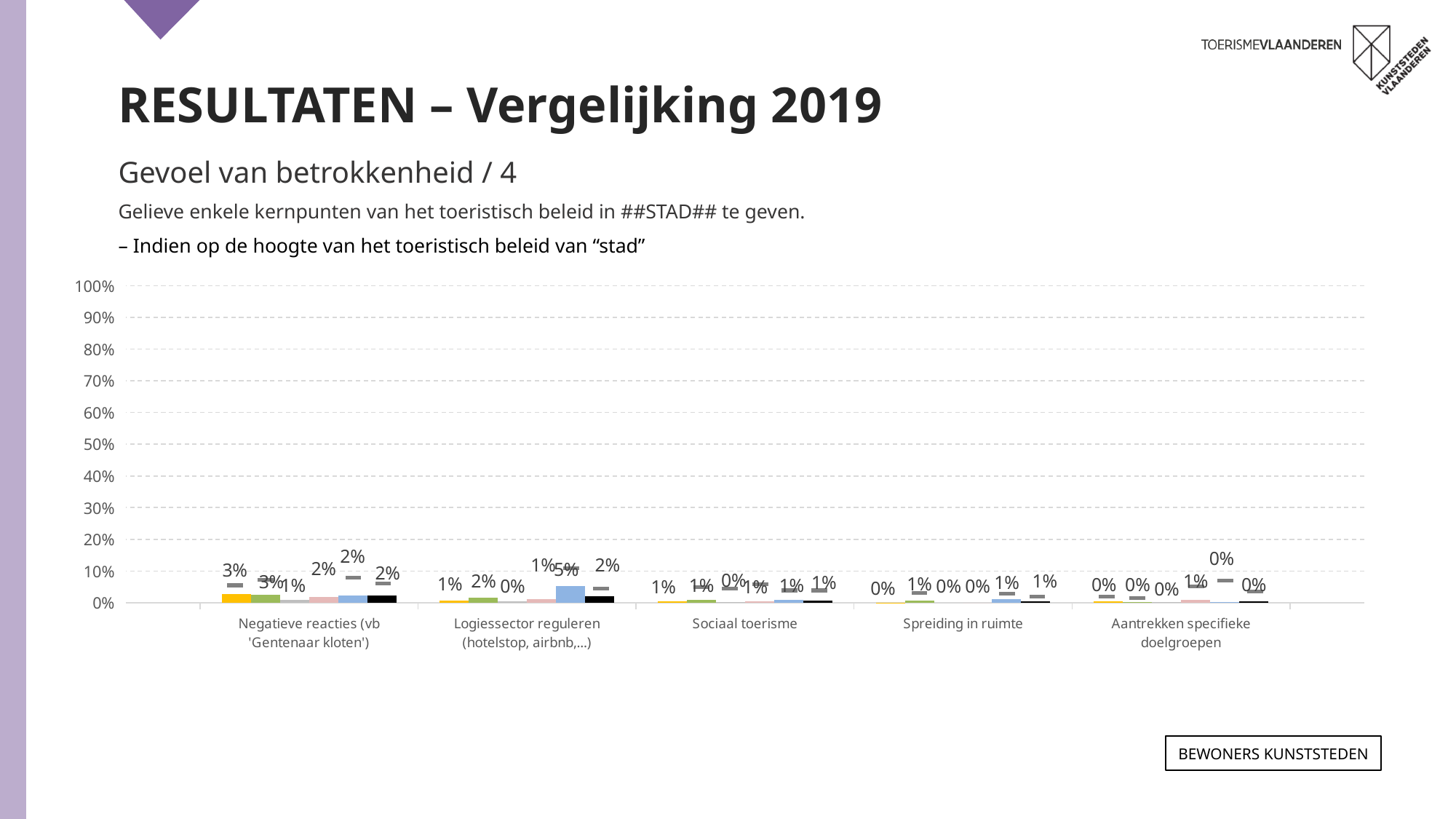
How many bars are plotted for each category in the chart? 6 What is the value of the blue bar for 'Negatieve reacties (vb 'Gentenaar kloten')'? 2% Which category contains the tallest bar in the chart? Logiessector reguleren (hotelstop, airbnb,...) Is the value of the blue bar for 'Logiessector reguleren' greater or less than 10%? less What is the difference between the blue bar for 'Logiessector reguleren' (5%) and the blue bar for 'Negatieve reacties' (2%)? 3% What is the value of the yellow bar for 'Negatieve reacties (vb 'Gentenaar kloten')'? 3% What is the value of the blue bar for 'Logiessector reguleren (hotelstop, airbnb,...)'? 5% What is the label of the last category on the x axis? Aantrekken specifieke doelgroepen How many categories are shown on the x axis of the chart? 5 What kind of chart is shown on the slide? bar chart What is the highest value shown on the y axis of the chart? 100% Which is larger: the blue bar for 'Logiessector reguleren' or the blue bar for 'Negatieve reacties'? Logiessector reguleren